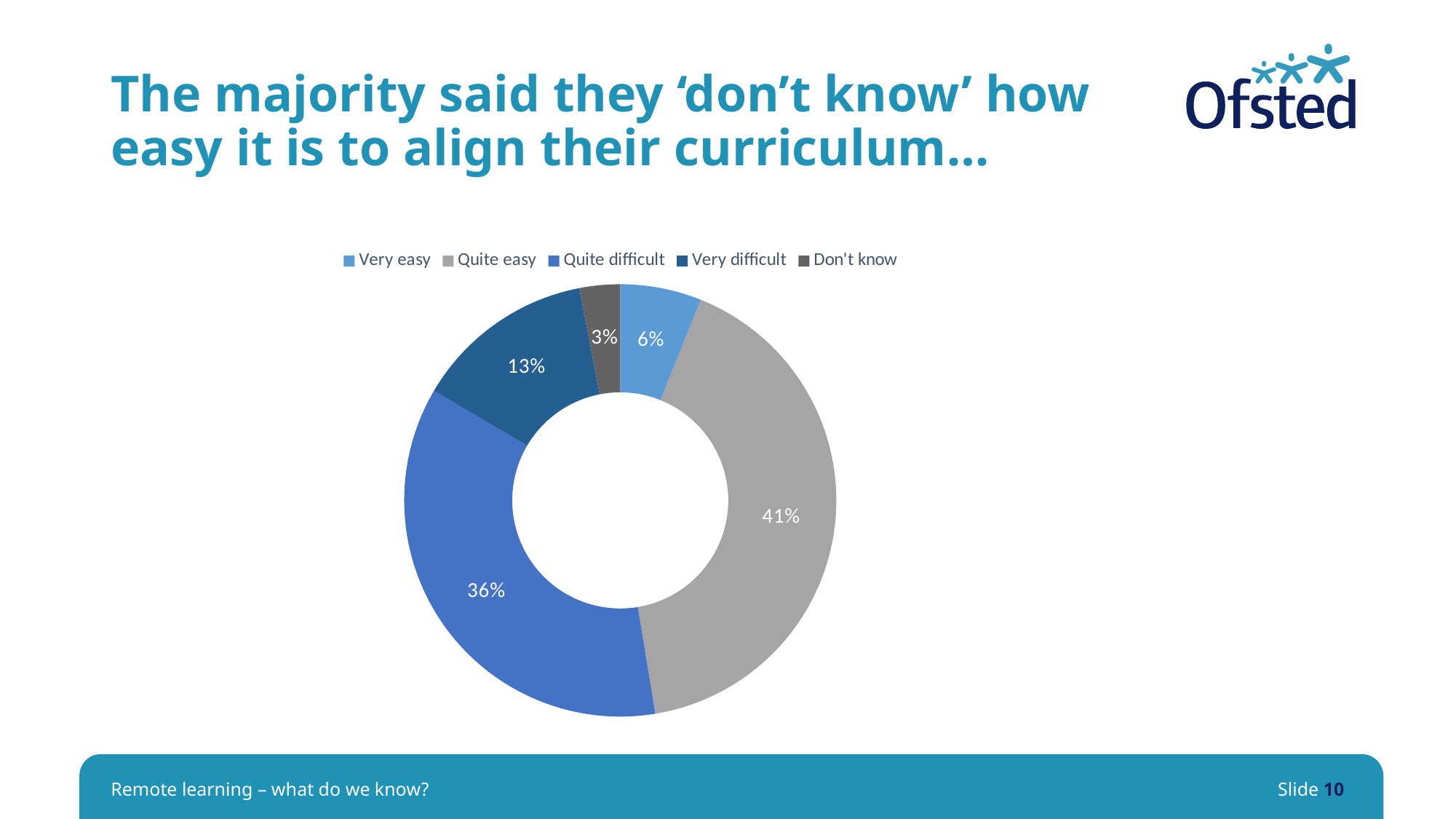
What percentage of respondents said 'Very easy'? 6% Which is larger, the share for 'Very difficult' or the share for 'Very easy'? Very difficult How many response categories are shown in the chart? 5 What colour is the 'Quite easy' slice in the chart? Grey What type of chart is shown on the slide? Doughnut chart What percentage of respondents said 'Don't know'? 3% What percentage of respondents said 'Very difficult'? 13% What is the difference in percentage points between 'Quite easy' and 'Quite difficult'? 5 What percentage of respondents said 'Quite easy'? 41% Which response category has the smallest share of the chart? Don't know What percentage of respondents said 'Quite difficult'? 36% Which response category has the largest share of the chart? Quite easy